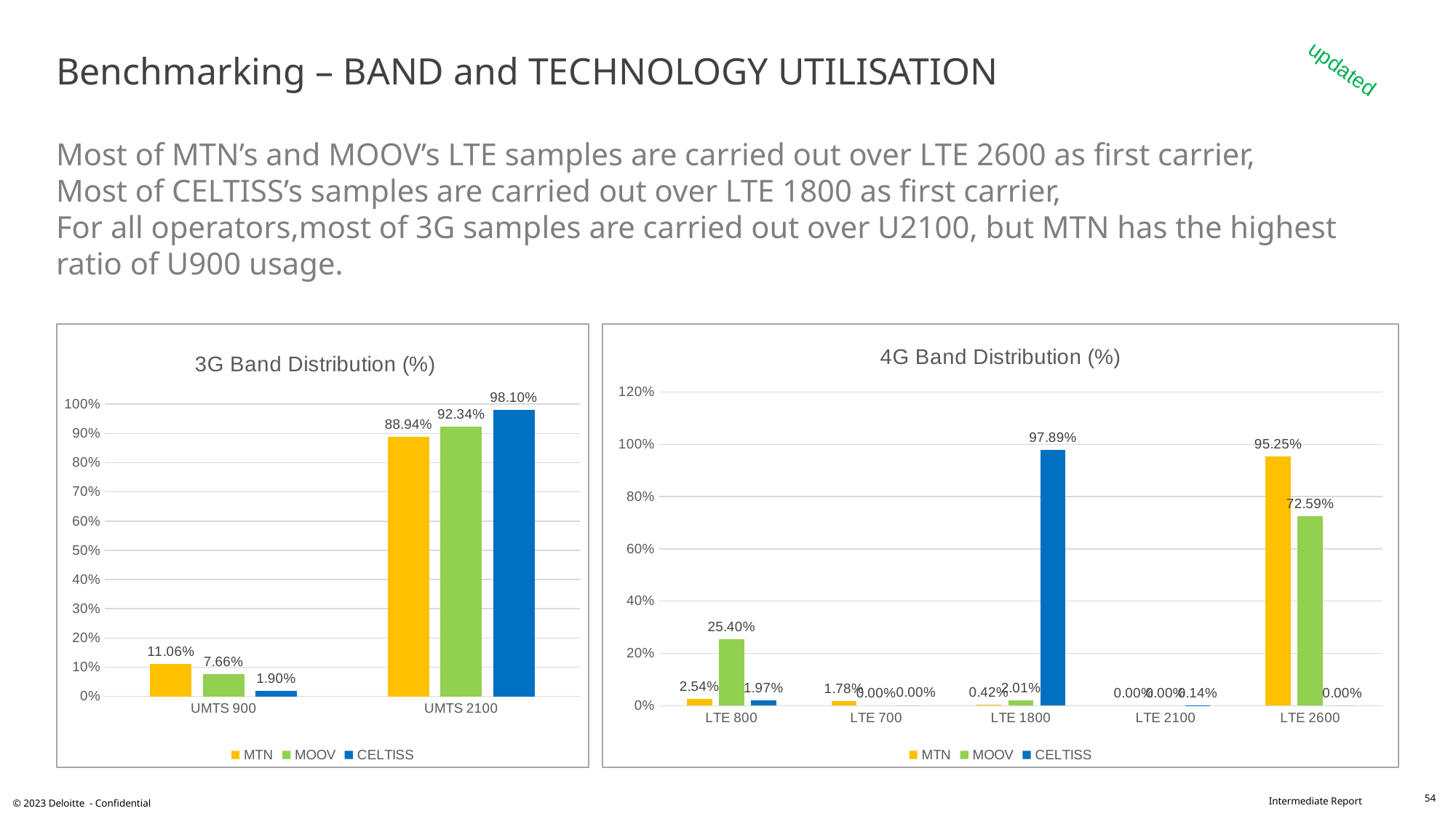
In the 3G Band Distribution (%) chart, what is the difference between MOOV's and MTN's values at UMTS 2100? 3.40% In the 4G Band Distribution (%) chart, which is larger at LTE 2600, MTN or MOOV? MTN How many series does the legend of the 3G Band Distribution (%) chart list? 3 In the 3G Band Distribution (%) chart, which operator has the highest value at UMTS 2100? CELTISS In the 4G Band Distribution (%) chart, what is the difference between MTN's and MOOV's values at LTE 2600? 22.66% In the 4G Band Distribution (%) chart, what is the value for MOOV at LTE 2600? 72.59% In the 4G Band Distribution (%) chart, what is the value for CELTISS at LTE 1800? 97.89% In the 3G Band Distribution (%) chart, what is the value for CELTISS at UMTS 2100? 98.10% In the 3G Band Distribution (%) chart, which operator has the lowest value at UMTS 900? CELTISS How many LTE band categories are shown on the x axis of the 4G Band Distribution (%) chart? 5 In the 4G Band Distribution (%) chart, what is the value for MOOV at LTE 800? 25.40% In the 3G Band Distribution (%) chart, what is the value for MTN at UMTS 900? 11.06%